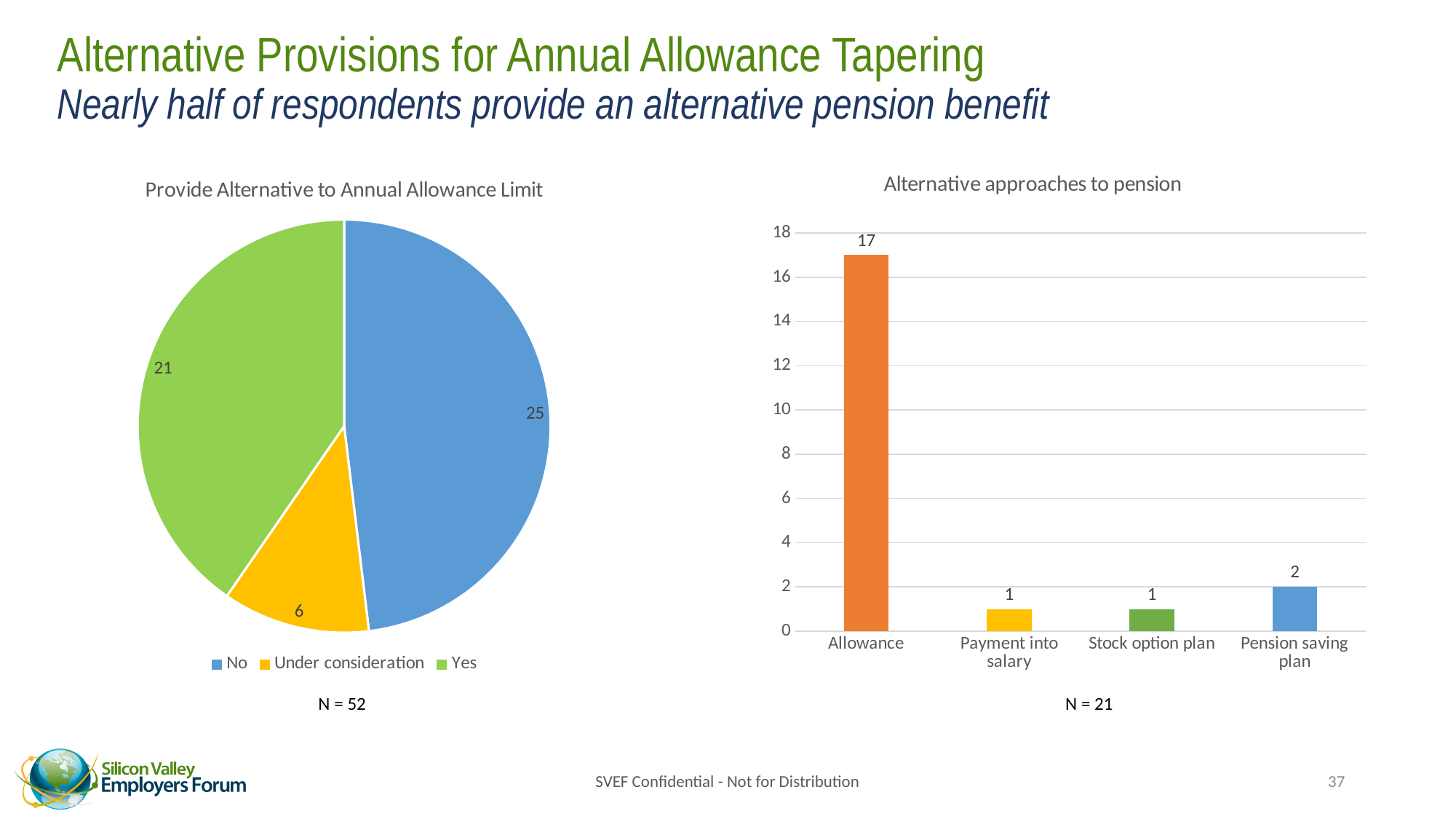
In the 'Alternative approaches to pension' chart, which category has the highest value? Allowance What kind of chart is 'Provide Alternative to Annual Allowance Limit'? Pie chart In the 'Alternative approaches to pension' chart, what is the difference between 'Allowance' and 'Pension saving plan'? 15 In the 'Provide Alternative to Annual Allowance Limit' chart, what is the difference between the 'No' and 'Yes' values? 4 In the 'Provide Alternative to Annual Allowance Limit' chart, which category has the largest slice? No In the 'Alternative approaches to pension' chart, what is the value for 'Allowance'? 17 In the 'Alternative approaches to pension' chart, how many categories are shown on the x axis? 4 In the 'Alternative approaches to pension' chart, what is the value for 'Pension saving plan'? 2 In the 'Provide Alternative to Annual Allowance Limit' chart, how many categories does the legend list? 3 In the 'Provide Alternative to Annual Allowance Limit' chart, what is the value for 'No'? 25 What kind of chart is 'Alternative approaches to pension'? Bar chart In the 'Provide Alternative to Annual Allowance Limit' chart, what is the value for 'Under consideration'? 6